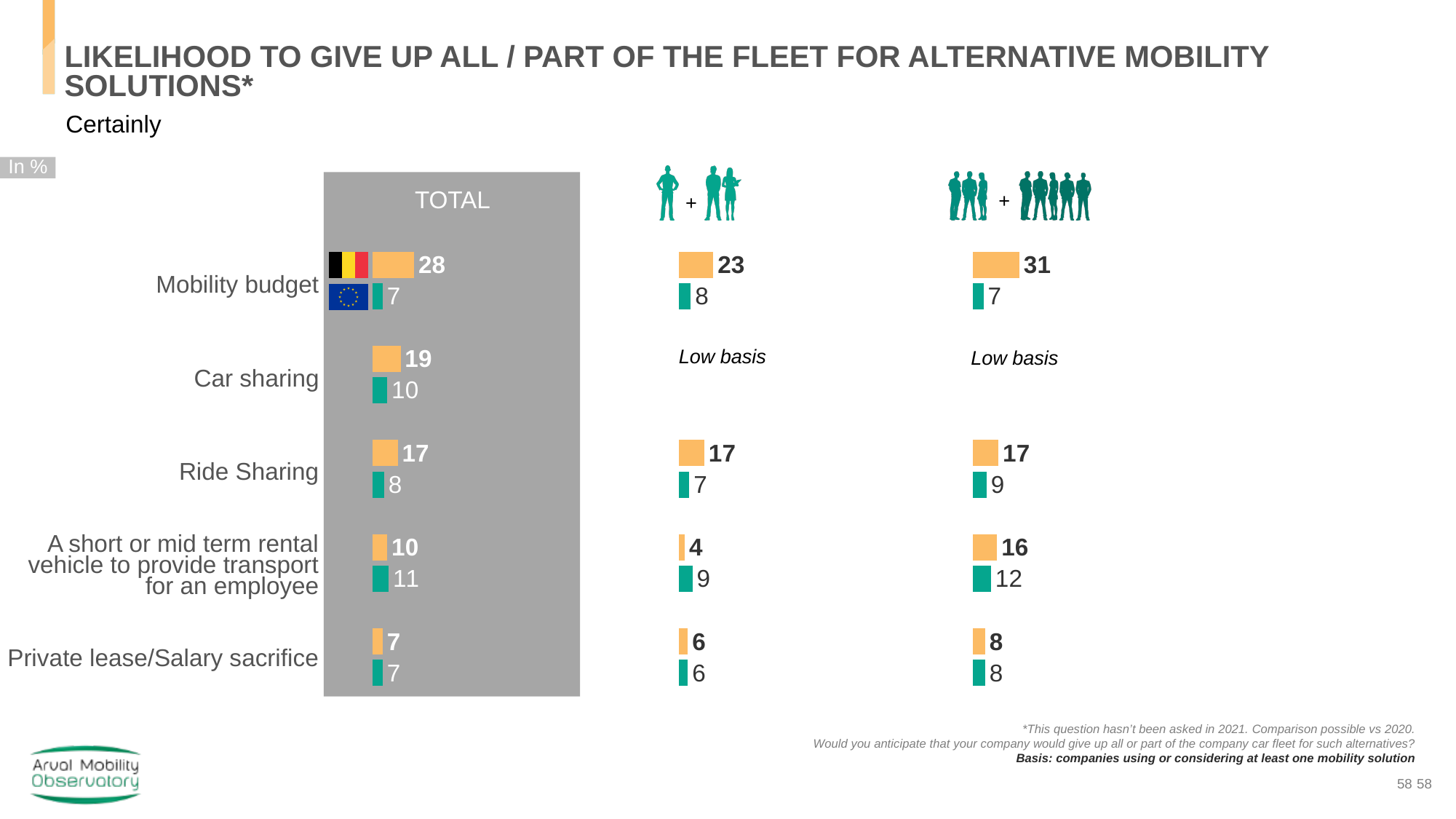
In the right-hand chart, what is the Belgium (orange) value for Mobility budget? 31 How many categories are listed down the left side of the slide? 5 In the TOTAL chart, which category has the highest Belgium (orange) value? Mobility budget In the TOTAL chart, for the short or mid term rental vehicle category, which is larger: the Belgium value or the Europe value? Europe In the TOTAL chart, what is the Europe (green) value for Car sharing? 10 In the middle chart, what is shown instead of values for Car sharing? Low basis In the TOTAL chart, what is the Belgium (orange) value for Mobility budget? 28 In the middle chart, what is the Belgium (orange) value for Mobility budget? 23 In the right-hand chart, what is the Europe (green) value for the short or mid term rental vehicle category? 12 In the TOTAL chart, what is the difference between the Belgium and Europe values for Mobility budget? 21 What type of chart is used on this slide? Bar chart In the TOTAL chart, which category has the lowest Belgium (orange) value? Private lease/Salary sacrifice